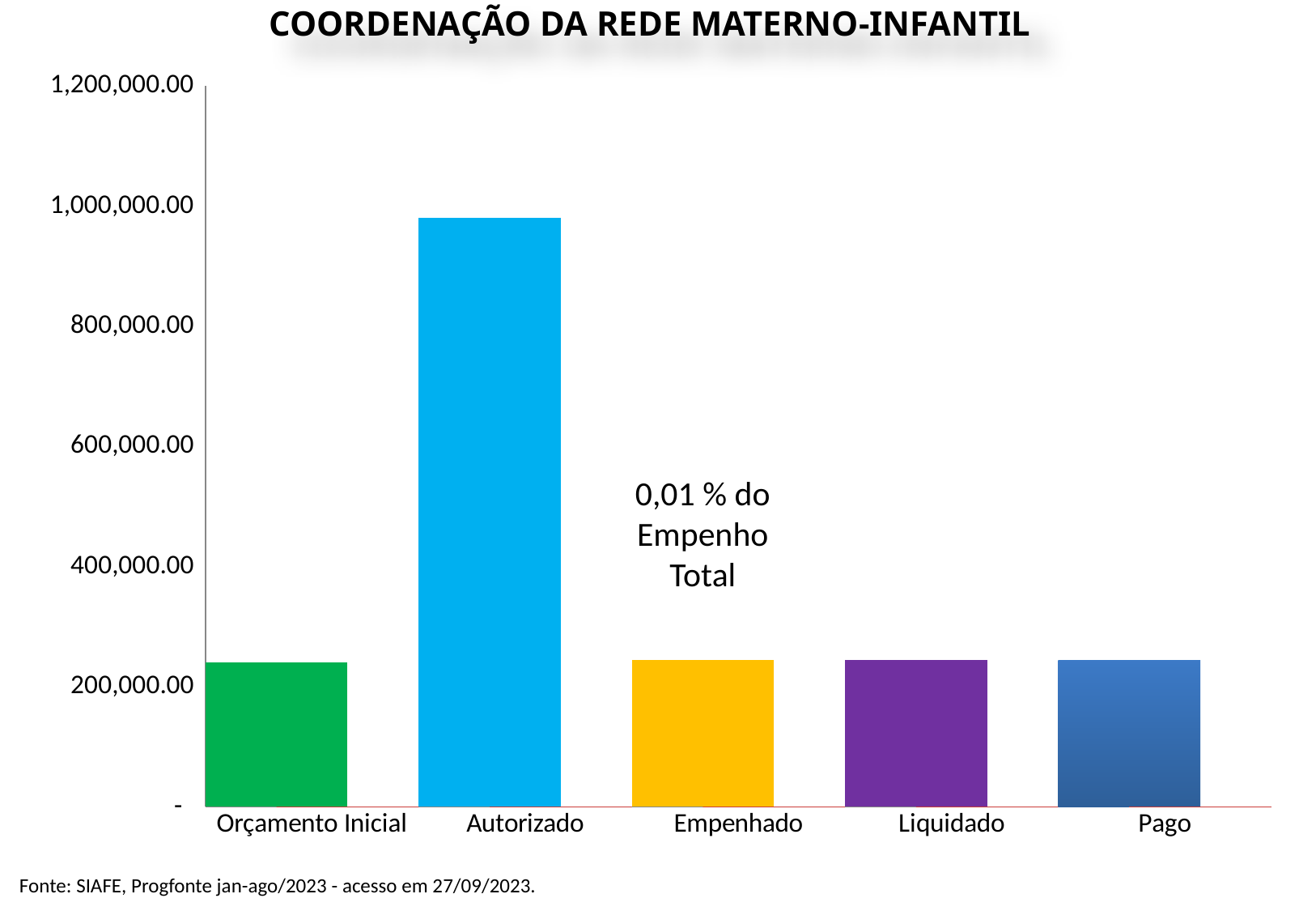
What kind of chart is shown on the slide? bar chart Is the value for Pago greater or less than 200,000.00? greater How many categories are shown on the x axis? 5 Is the value for Empenhado greater or less than 400,000.00? less Which is larger, the value for Autorizado or the value for Liquidado? Autorizado Which category has the highest value? Autorizado Which is larger, the value for Autorizado or the value for Orçamento Inicial? Autorizado Is the value for Orçamento Inicial greater or less than 200,000.00? greater What text annotation appears above the Empenhado bar? 0,01 % do Empenho Total What is the title of the chart? COORDENAÇÃO DA REDE MATERNO-INFANTIL